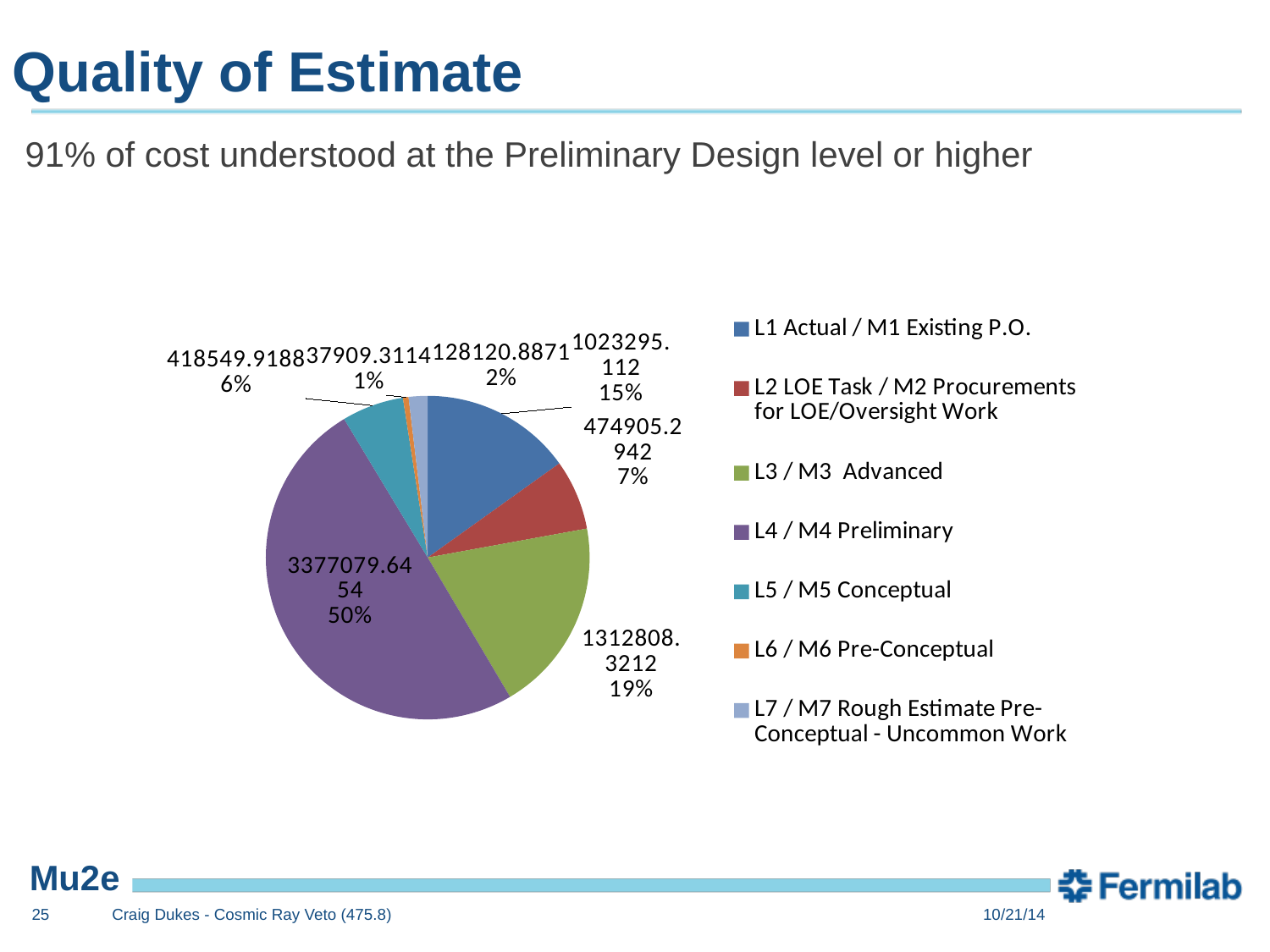
What share of the pie does L4 / M4 Preliminary represent? 50% What is the difference in percentage points between the share for L4 / M4 Preliminary and the share for L3 / M3 Advanced? 31 What share of the pie does L3 / M3 Advanced represent? 19% What is the title of the slide containing the pie chart? Quality of Estimate What value is printed on the slice for L4 / M4 Preliminary? 3377079.6454 How many entries does the legend list? 7 How many slices does the pie chart have? 7 Which category has the smallest slice of the pie? L6 / M6 Pre-Conceptual Which is larger, the share for L1 Actual / M1 Existing P.O. or the share for L3 / M3 Advanced? L3 / M3 Advanced What kind of chart is shown on the slide? pie chart Which category has the largest slice of the pie? L4 / M4 Preliminary What share of the pie does L1 Actual / M1 Existing P.O. represent? 15%